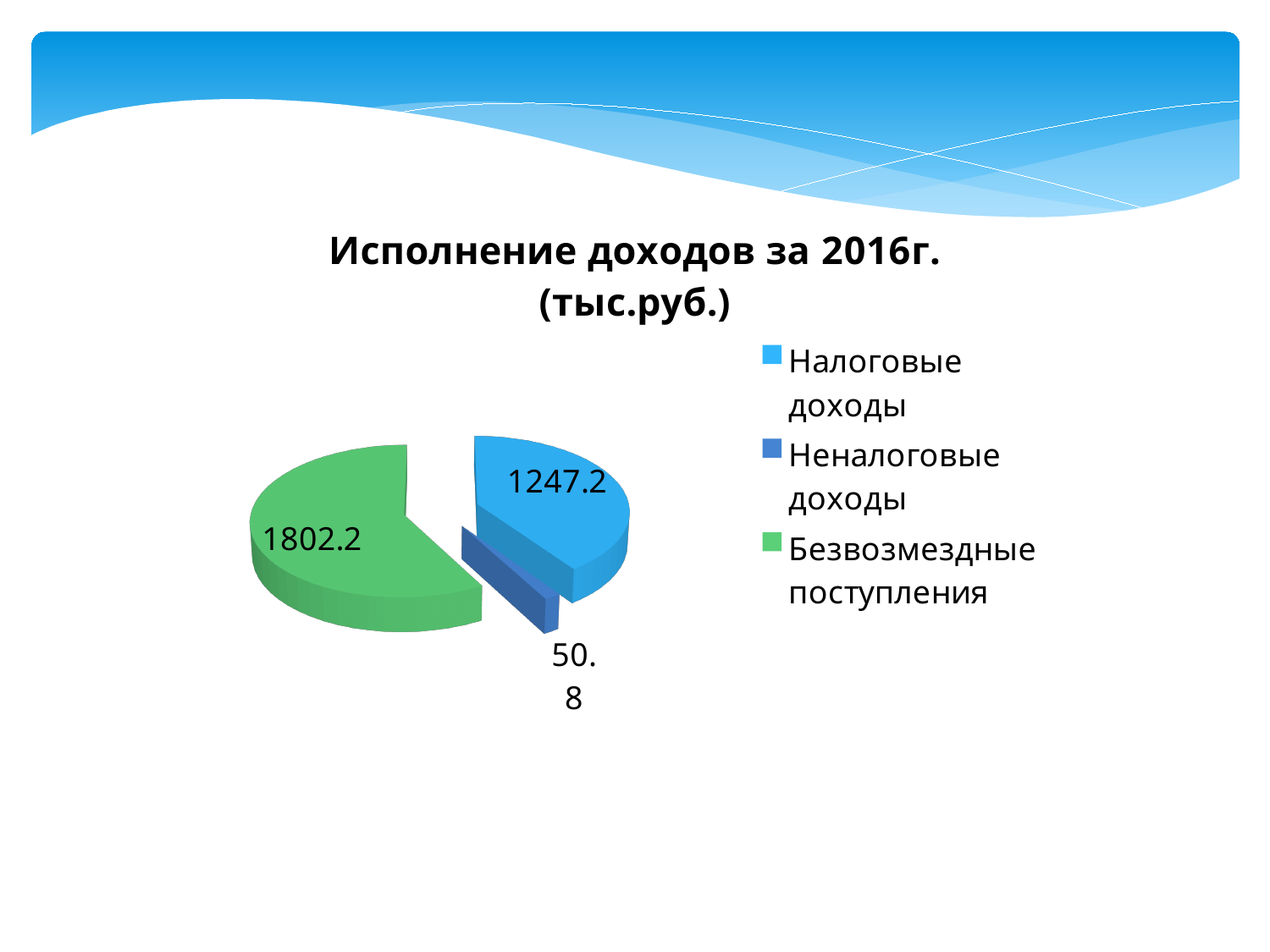
What is the total of all slices in the pie chart? 3100.2 What type of chart is shown on the slide? Pie chart Which category has the smallest value? Неналоговые доходы What is the difference between Налоговые доходы and Неналоговые доходы? 1196.4 What is the value for Неналоговые доходы? 50.8 What is the title of the chart? Исполнение доходов за 2016г. (тыс.руб.) Which category has the largest value? Безвозмездные поступления Which is larger, Налоговые доходы or Безвозмездные поступления? Безвозмездные поступления What is the difference between Безвозмездные поступления and Налоговые доходы? 555.0 What is the value for Безвозмездные поступления? 1802.2 How many slices does the pie chart have? 3 What is the value for Налоговые доходы? 1247.2